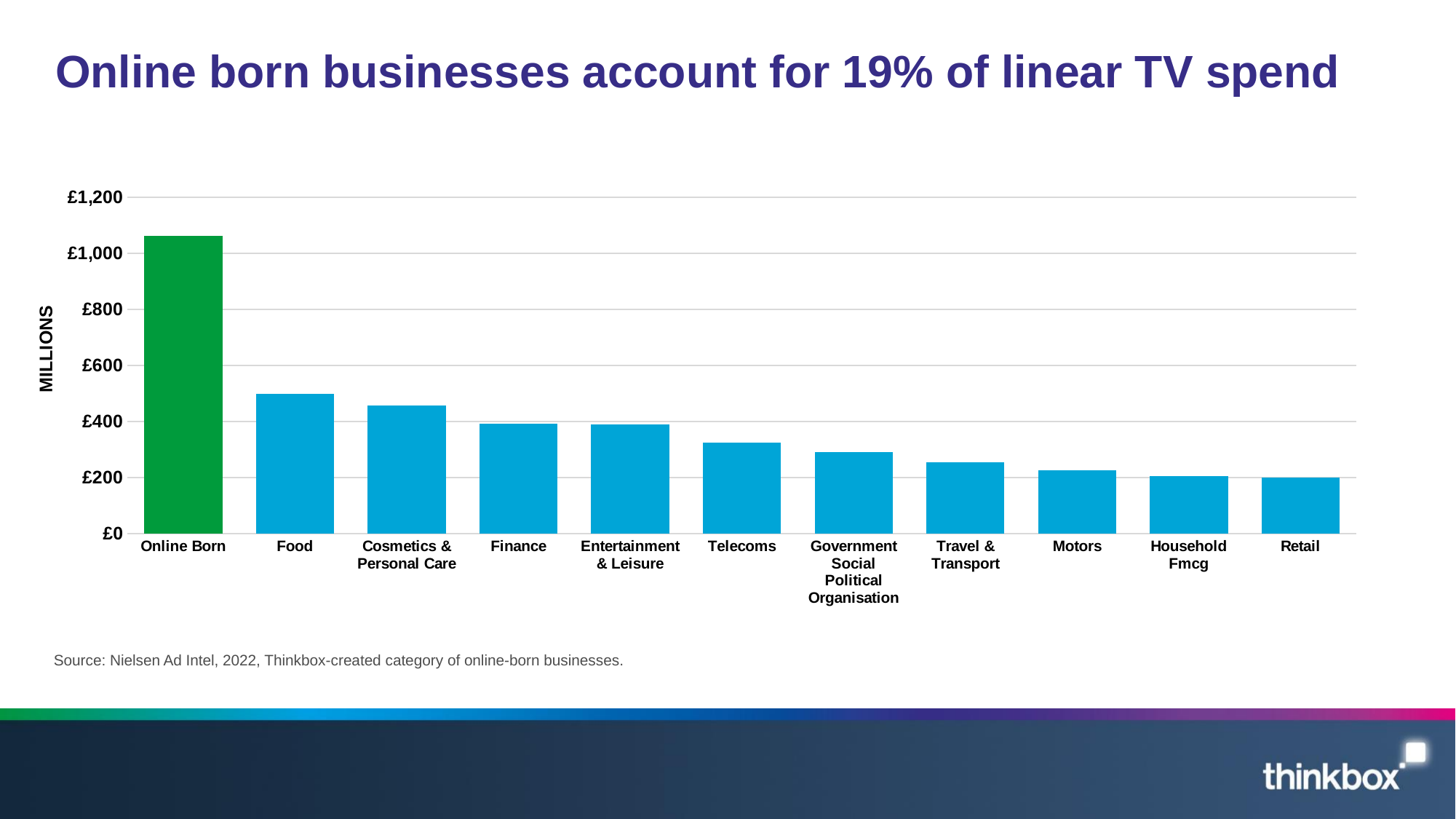
Is the value for Finance greater or less than £600? less Which category has the highest linear TV spend? Online Born Is the value for Telecoms greater or less than £400? less Is the value for Government Social Political Organisation greater or less than £200? greater Which is larger, the value for Food or the value for Cosmetics & Personal Care? Food What is the label on the vertical axis of the chart? MILLIONS What kind of chart is shown on the slide? Bar chart Do the values rise or fall moving from left to right along the x axis? Fall How many categories are shown on the x axis of the chart? 11 Which is larger, the value for Telecoms or the value for Government Social Political Organisation? Telecoms